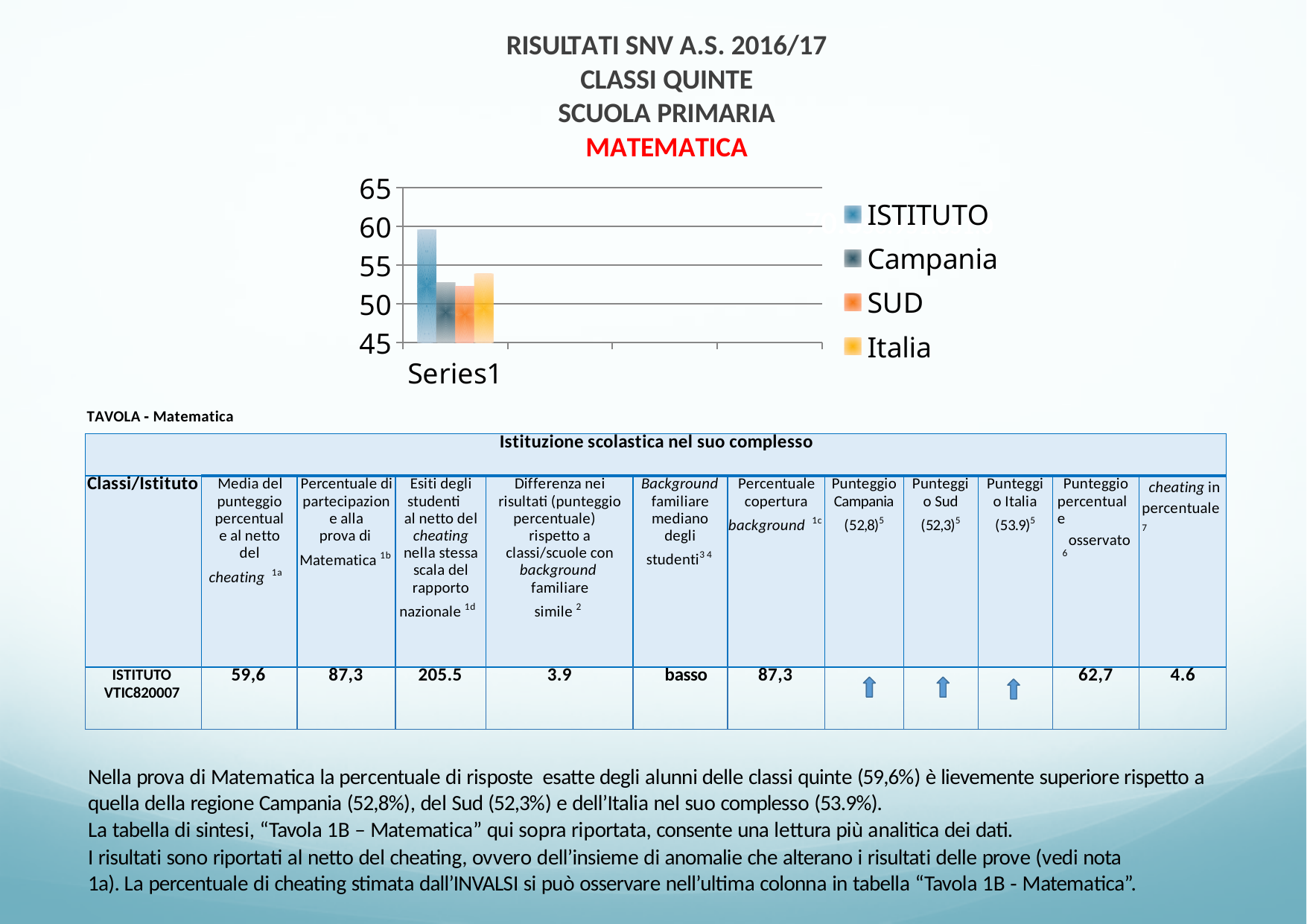
Is the value for Campania greater or less than 50? greater What is the label shown on the x axis of the chart? Series1 How many categories are shown on the x axis of the chart? 1 Is the value for ISTITUTO greater or less than 55? greater Is the value for Italia greater or less than 55? less Which is larger, the bar for Italia or the bar for SUD? Italia What kind of chart is shown on the slide? bar chart How many series does the chart legend list? 4 Which is larger, the bar for ISTITUTO or the bar for Italia? ISTITUTO Which series has the highest bar in the chart? ISTITUTO